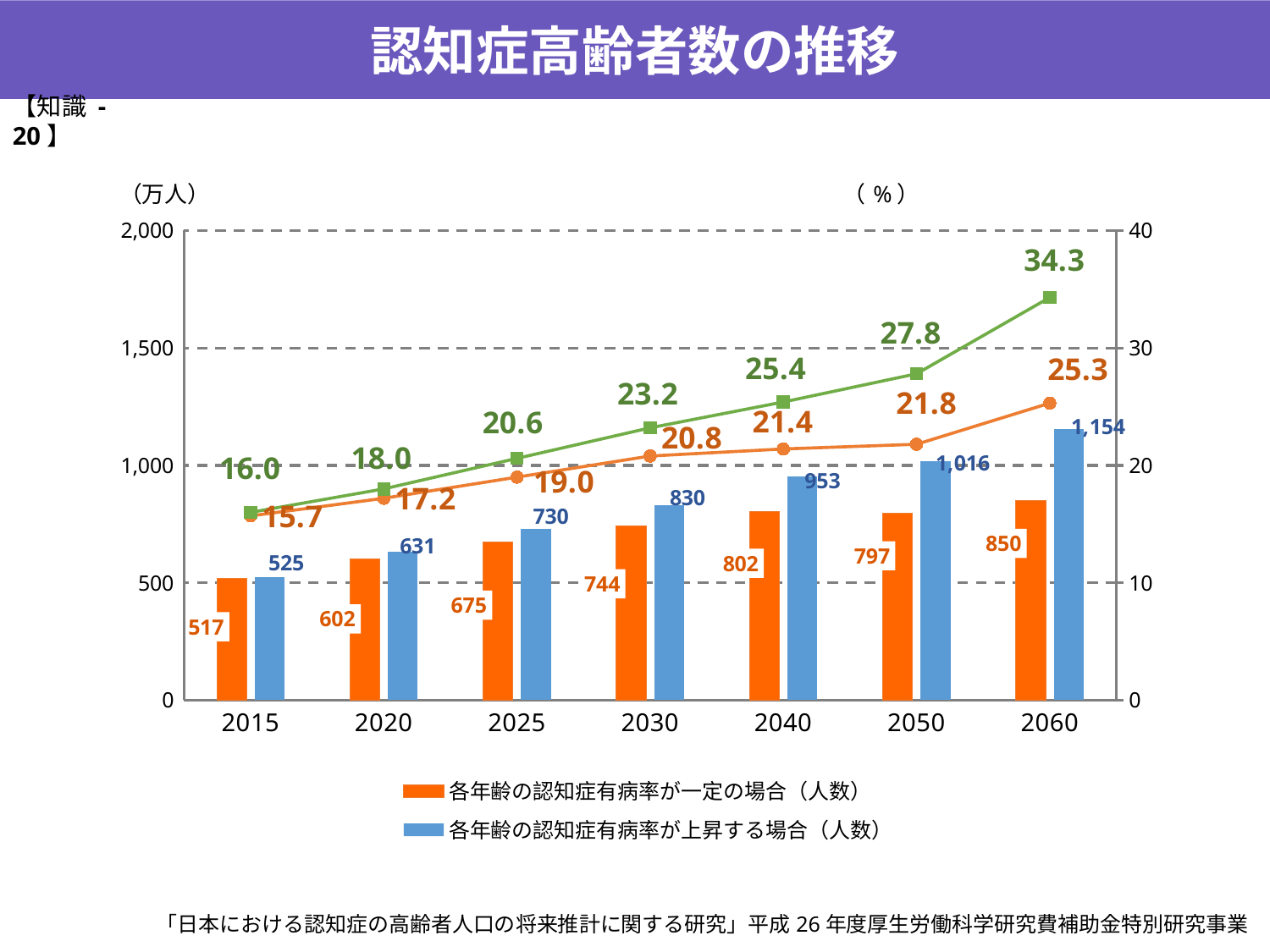
How many series does the legend list? 2 How many years are shown on the x axis? 7 Which is larger in 2040: the orange bar (802) or the blue bar (953)? the blue bar (953) In which year is the orange bar (各年齢の認知症有病率が一定の場合) lowest? 2015 What kind of chart is shown on the slide? a combined bar and line chart What is the value of the blue bar (各年齢の認知症有病率が上昇する場合) for 2060? 1,154 Does the green line rise or fall from 2015 to 2060? rise What percentage does the orange line show for 2025? 19.0 What is the difference between the blue bar and the orange bar in 2050? 219 In which year is the blue bar (各年齢の認知症有病率が上昇する場合) highest? 2060 What is the value of the orange bar (各年齢の認知症有病率が一定の場合) for 2015? 517 What percentage does the green line show for 2040? 25.4